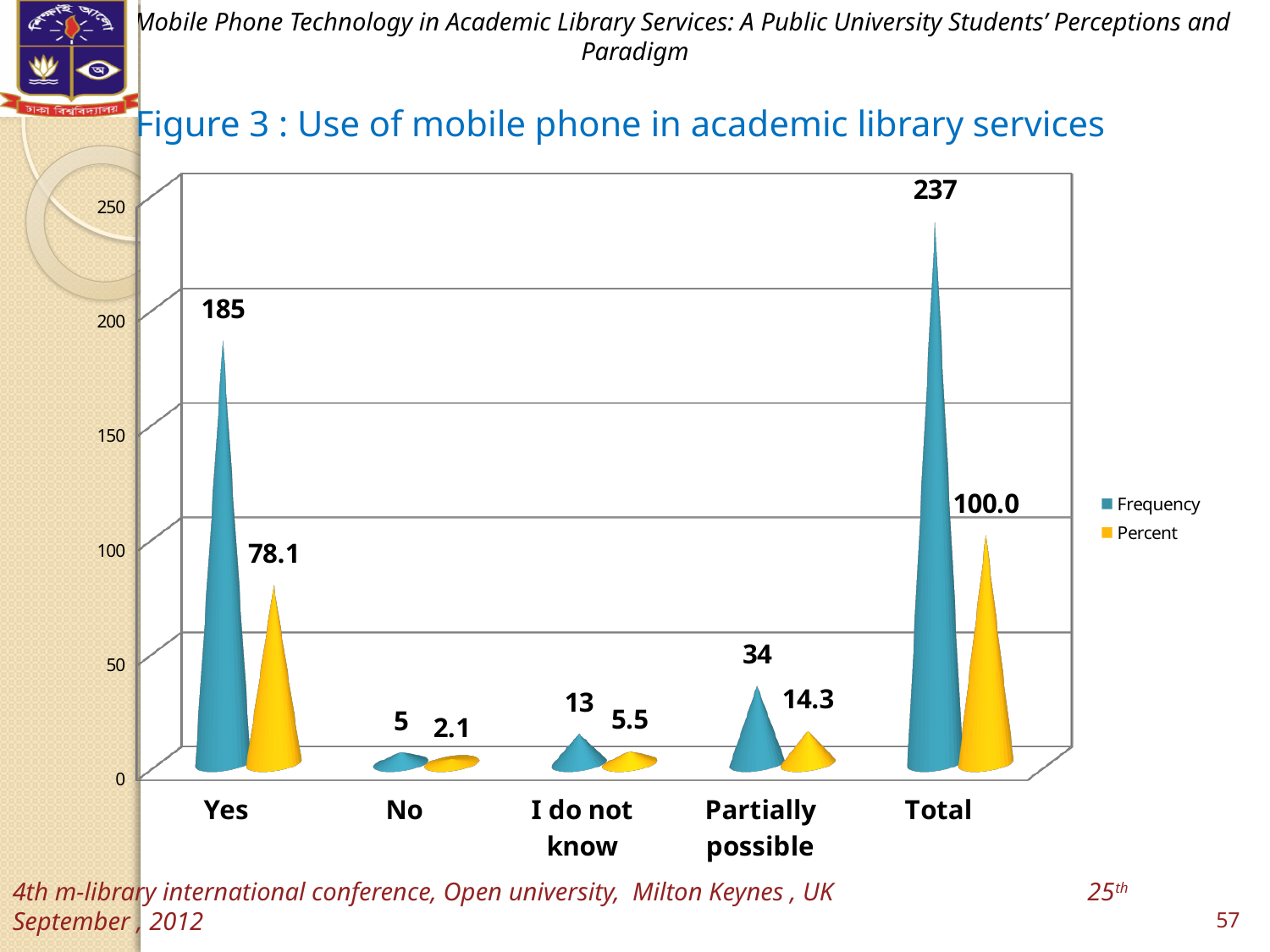
What is the Percent value for "No"? 2.1 Excluding the Total category, which category has the highest Frequency? Yes Which category has the lowest Frequency? No What kind of chart is shown on the slide? bar chart What is the difference between the Frequency values for "Yes" and "Partially possible"? 151 Is the Frequency value for "Total" greater or less than 200? greater What is the Percent value for "Partially possible"? 14.3 Which is larger, the Frequency for "I do not know" or the Frequency for "Partially possible"? Partially possible How many series does the legend list? 2 How many categories are shown on the x axis? 5 What is the Frequency value for "Yes"? 185 What is the Frequency value for "I do not know"? 13